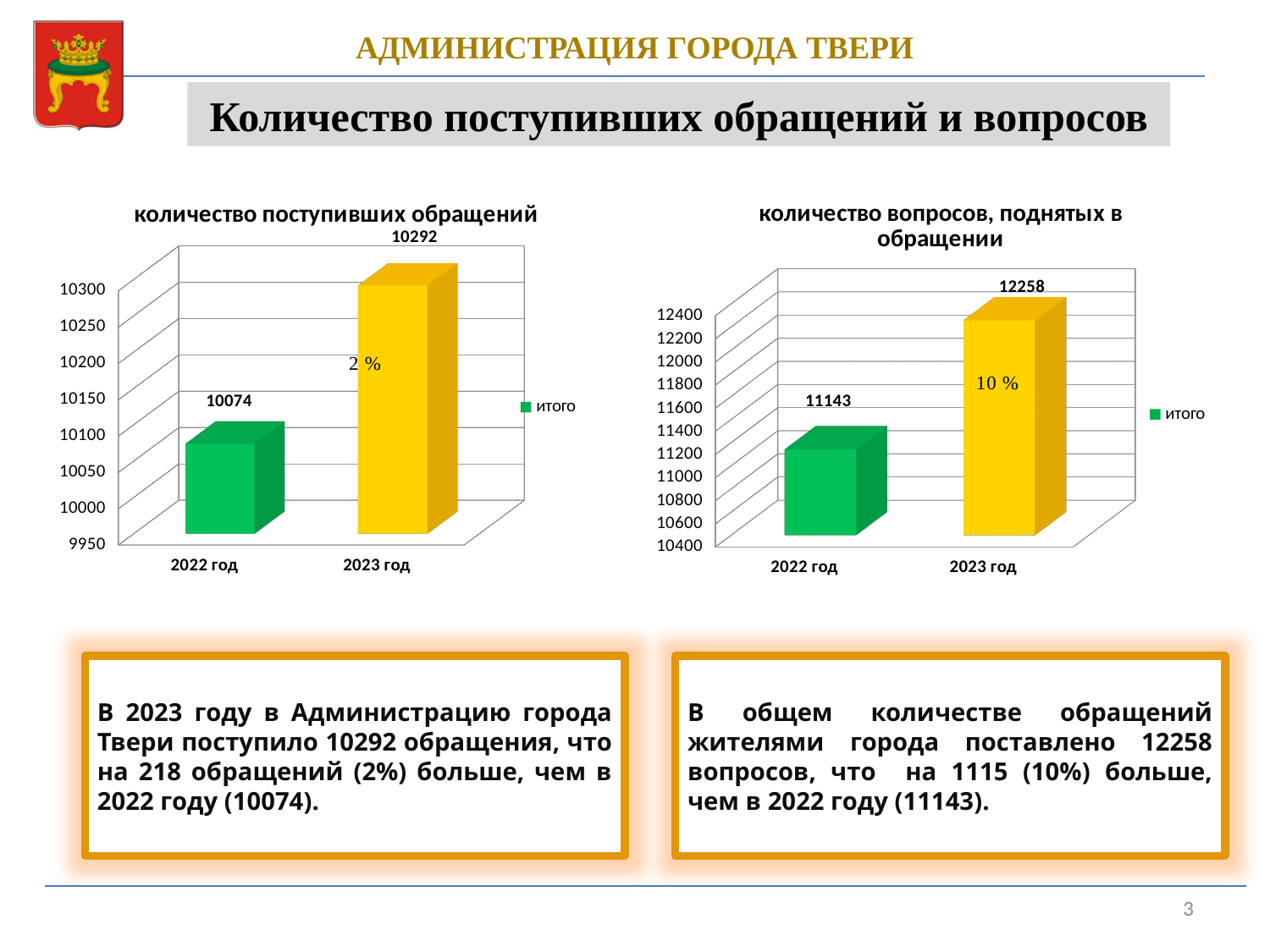
In the chart titled "количество вопросов, поднятых в обращении", what is the value for 2022 год? 11143 In the chart titled "количество поступивших обращений", what is the difference between the 2023 год and 2022 год values? 218 In the chart titled "количество вопросов, поднятых в обращении", what is the difference between the 2023 год and 2022 год values? 1115 What legend entry is shown in the chart titled "количество поступивших обращений"? итого In the chart titled "количество вопросов, поднятых в обращении", which year has the lower value? 2022 год How many categories are shown on the x axis of the chart titled "количество поступивших обращений"? 2 In the chart titled "количество поступивших обращений", what is the value for 2023 год? 10292 In the chart titled "количество поступивших обращений", what is the value for 2022 год? 10074 In the chart titled "количество вопросов, поднятых в обращении", what is the value for 2023 год? 12258 What kind of chart is the chart titled "количество вопросов, поднятых в обращении"? bar chart In the chart titled "количество поступивших обращений", which year has the higher value? 2023 год In the chart titled "количество вопросов, поднятых в обращении", is the value for 2022 год greater or less than 11400? less